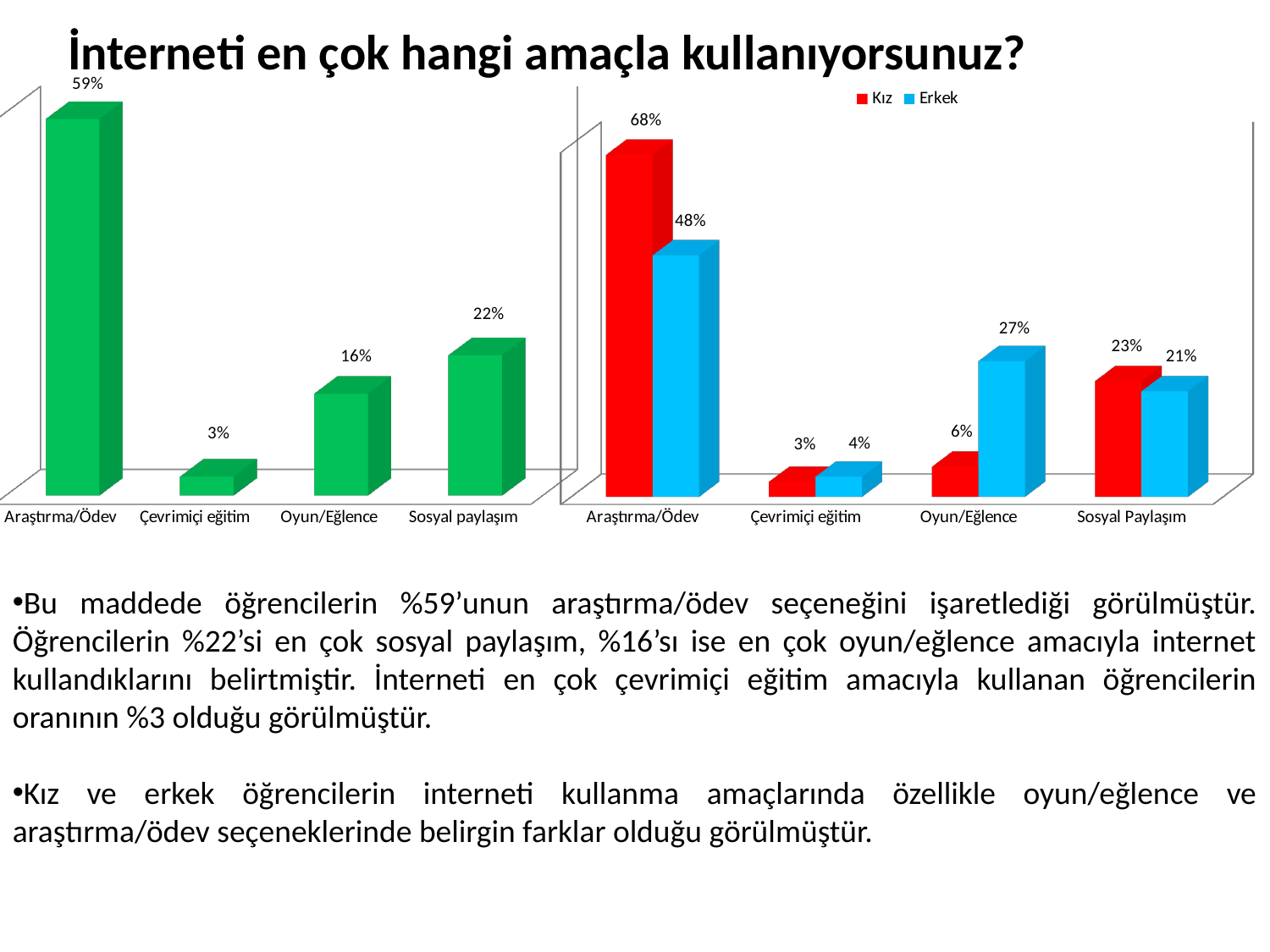
In the left chart, how many categories are shown? 4 In the left chart, what is the value for Araştırma/Ödev? 59% In the right chart, what is the difference between the Kız and Erkek values for Araştırma/Ödev? 20% In the left chart, which category has the lowest value? Çevrimiçi eğitim In the right chart, what colour represents the Kız series? Red In the right chart, how many series does the legend list? 2 In the left chart, what is the difference between Sosyal paylaşım and Oyun/Eğlence? 6% In the right chart, which series has the larger value for Oyun/Eğlence, Kız or Erkek? Erkek In the right chart, what is the Kız value for Araştırma/Ödev? 68% In the right chart, which category has the highest Erkek value? Araştırma/Ödev What kind of chart is the left chart? Bar chart In the right chart, what is the Erkek value for Oyun/Eğlence? 27%